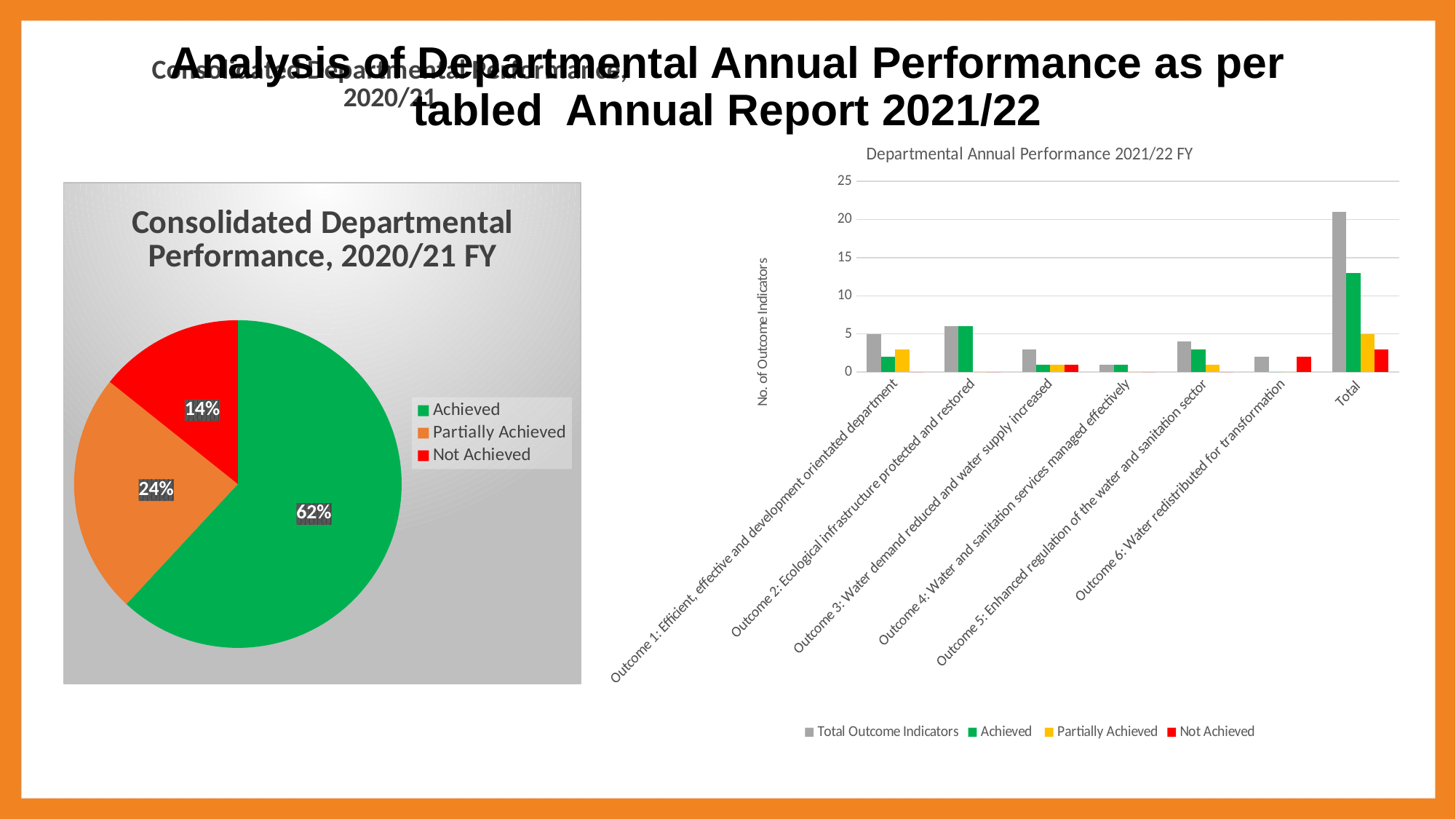
On the chart titled 'Departmental Annual Performance 2021/22 FY', which category has the highest Total Outcome Indicators bar? Total On the pie chart titled 'Consolidated Departmental Performance, 2020/21 FY', what share is labelled for Achieved? 62% On the pie chart titled 'Consolidated Departmental Performance, 2020/21 FY', what share is labelled for Not Achieved? 14% On the pie chart titled 'Consolidated Departmental Performance, 2020/21 FY', which category has the smallest slice? Not Achieved What kind of chart is the chart titled 'Departmental Annual Performance 2021/22 FY'? Bar chart On the chart titled 'Departmental Annual Performance 2021/22 FY', is the Achieved value for the Total category greater or less than 10? greater On the pie chart titled 'Consolidated Departmental Performance, 2020/21 FY', what share is labelled for Partially Achieved? 24% On the pie chart titled 'Consolidated Departmental Performance, 2020/21 FY', what is the difference in percentage points between Achieved and Partially Achieved? 38 On the pie chart titled 'Consolidated Departmental Performance, 2020/21 FY', how many slices does the pie have? 3 What kind of chart is the chart on the left of the slide? Pie chart On the chart titled 'Departmental Annual Performance 2021/22 FY', how many series does the legend list? 4 On the chart titled 'Departmental Annual Performance 2021/22 FY', how many categories are shown on the x axis? 7